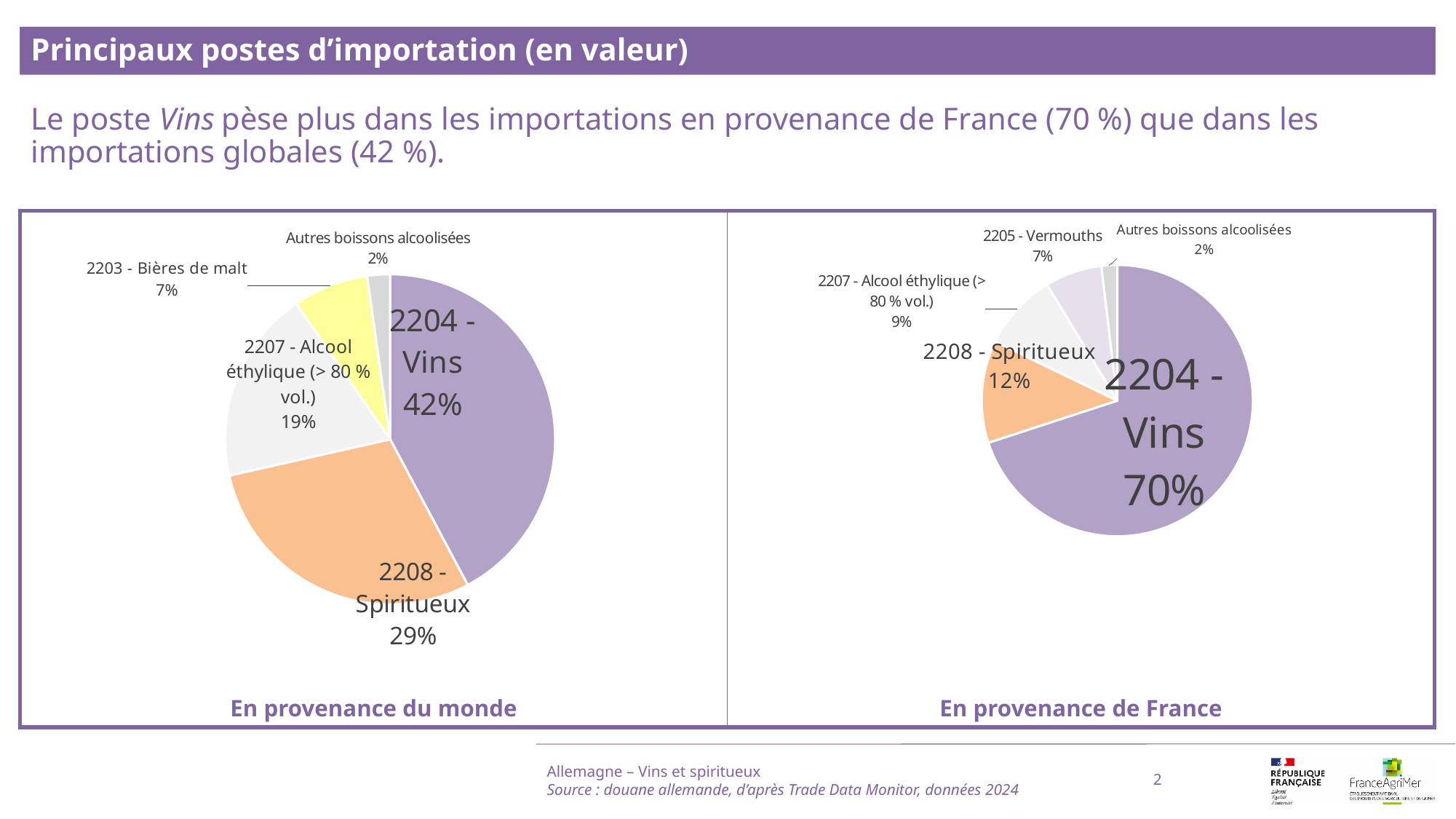
In the 'En provenance de France' chart, which is larger: 2208 - Spiritueux or 2207 - Alcool éthylique (> 80 % vol.)? 2208 - Spiritueux In the 'En provenance du monde' chart, what is the value for 2208 - Spiritueux? 29% In the 'En provenance du monde' chart, what is the value for 2207 - Alcool éthylique (> 80 % vol.)? 19% How many slices does the 'En provenance de France' pie chart have? 5 What type of chart is used in the 'En provenance du monde' panel? Pie chart In the 'En provenance de France' chart, which category has the smallest share? Autres boissons alcoolisées In the 'En provenance du monde' chart, what is the difference between 2208 - Spiritueux and 2207 - Alcool éthylique (> 80 % vol.)? 10 percentage points In the 'En provenance de France' chart, what is the value for 2205 - Vermouths? 7% In the 'En provenance du monde' chart, which category has the largest share? 2204 - Vins What is the difference between the share of 2204 - Vins in the 'En provenance de France' chart and in the 'En provenance du monde' chart? 28 percentage points In the 'En provenance de France' chart, what share does 2204 - Vins have? 70% In the 'En provenance du monde' chart, what share does 2204 - Vins have? 42%